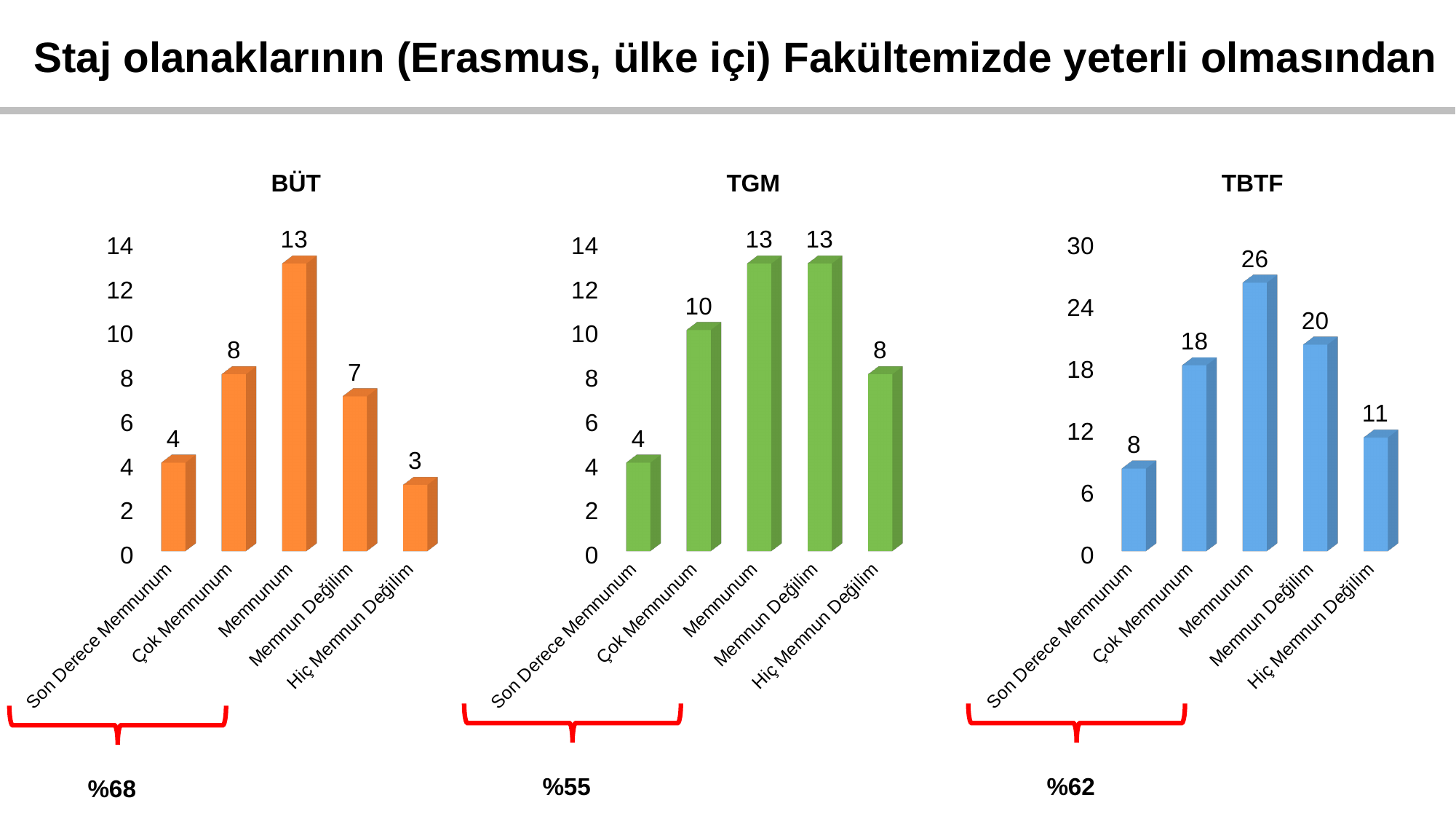
How many categories does the TBTF chart show? 5 What kind of chart is the TGM chart? Bar chart In the BÜT chart, what is the difference between the values for Çok Memnunum and Son Derece Memnunum? 4 In the BÜT chart, what is the value for Memnunum? 13 In the TGM chart, which is larger, the value for Çok Memnunum or the value for Hiç Memnun Değilim? Çok Memnunum In the TGM chart, what is the value for Çok Memnunum? 10 In the BÜT chart, which category has the lowest value? Hiç Memnun Değilim What percentage is written below the bracket under the BÜT chart? %68 In the TGM chart, which category has the lowest value? Son Derece Memnunum In the TBTF chart, which category has the highest value? Memnunum In the TBTF chart, what is the difference between the values for Memnunum and Memnun Değilim? 6 In the TBTF chart, what is the value for Hiç Memnun Değilim? 11